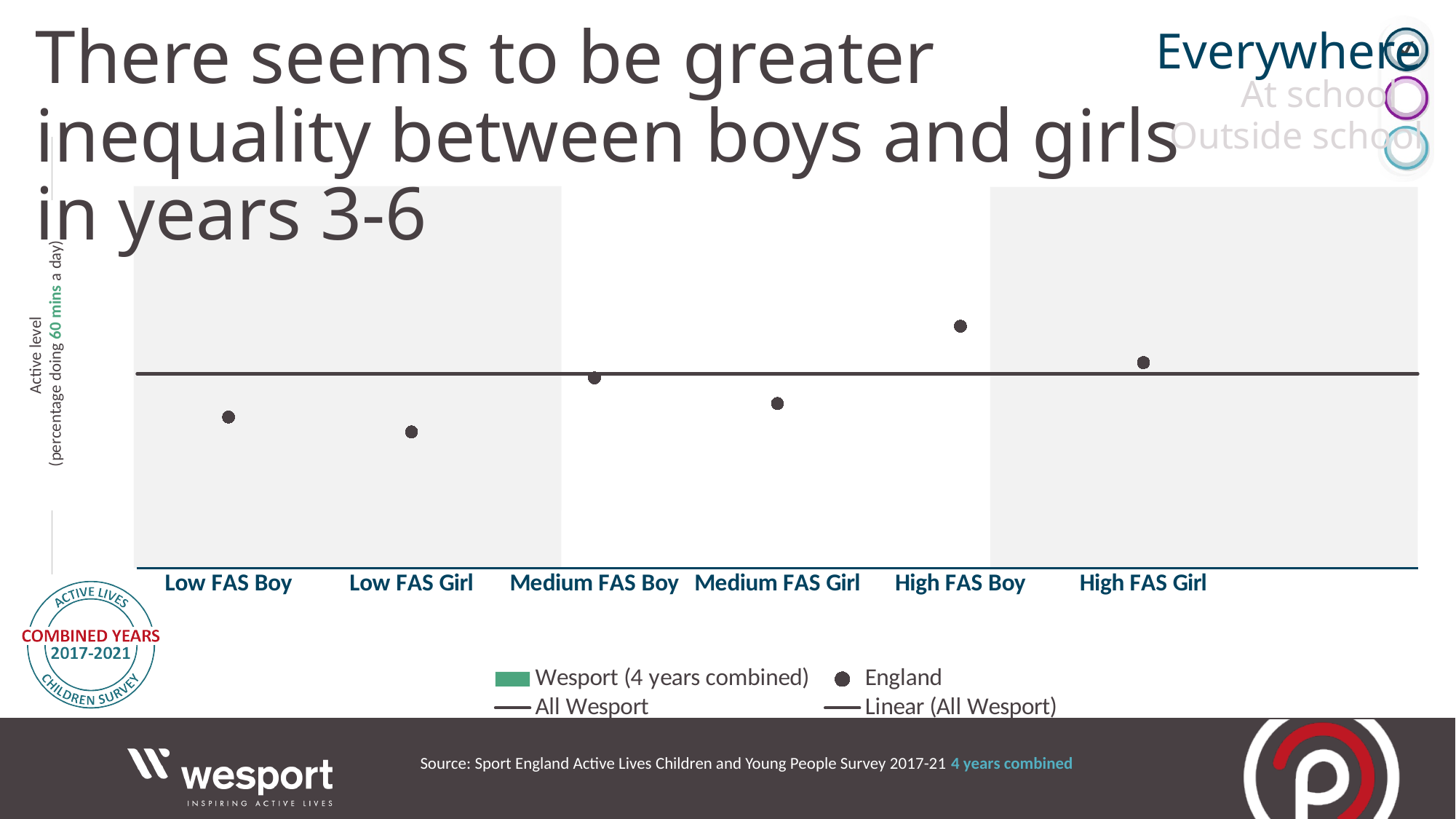
Which category has the lowest England value? Low FAS Girl Which category has the highest England value? High FAS Boy What is the label of the y axis of the chart? Active level (percentage doing 60 mins a day) How many series does the chart legend list? 4 Which legend entry is shown as a dot marker? England Is the England value higher for Medium FAS Boy or Medium FAS Girl? Medium FAS Boy Is the England value for Low FAS Boy above or below the All Wesport line? below Is the England value higher for Low FAS Boy or Medium FAS Boy? Medium FAS Boy How many categories are shown on the x axis of the chart? 6